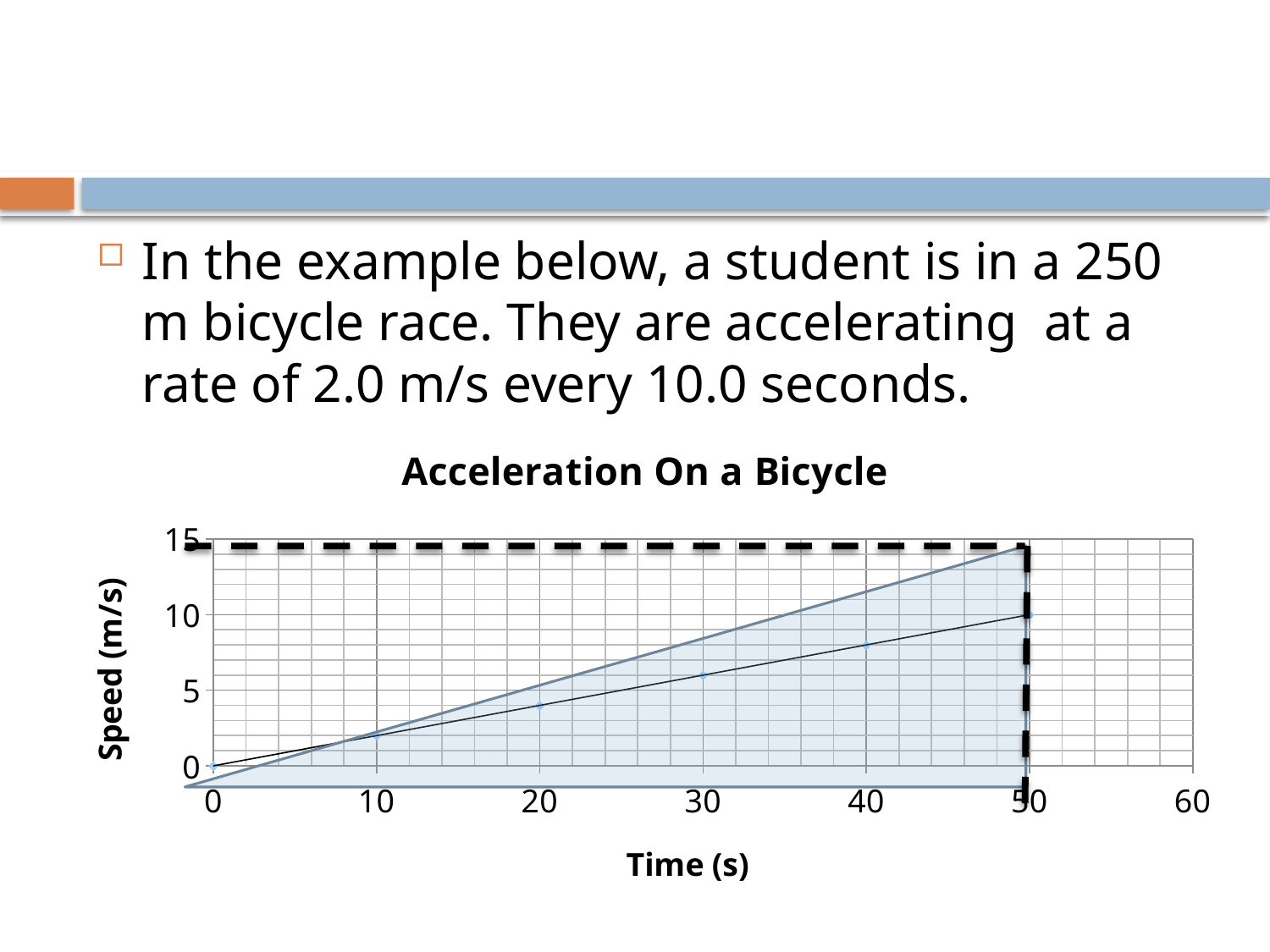
What is the title of the chart? Acceleration On a Bicycle Is the speed at 20 s greater or less than 5 m/s? less What is the speed at 0 s? 0 m/s What is the speed at 50 s? 10 m/s At which time is the speed lowest? 0 s What is the label of the x axis? Time (s) Is the speed at 30 s greater or less than 5 m/s? greater How many data points are plotted on the chart? 6 What kind of chart is shown on the slide? line chart Is the speed at 40 s greater or less than 10 m/s? less At which time is the speed highest? 50 s Does the speed rise or fall as time increases? rises